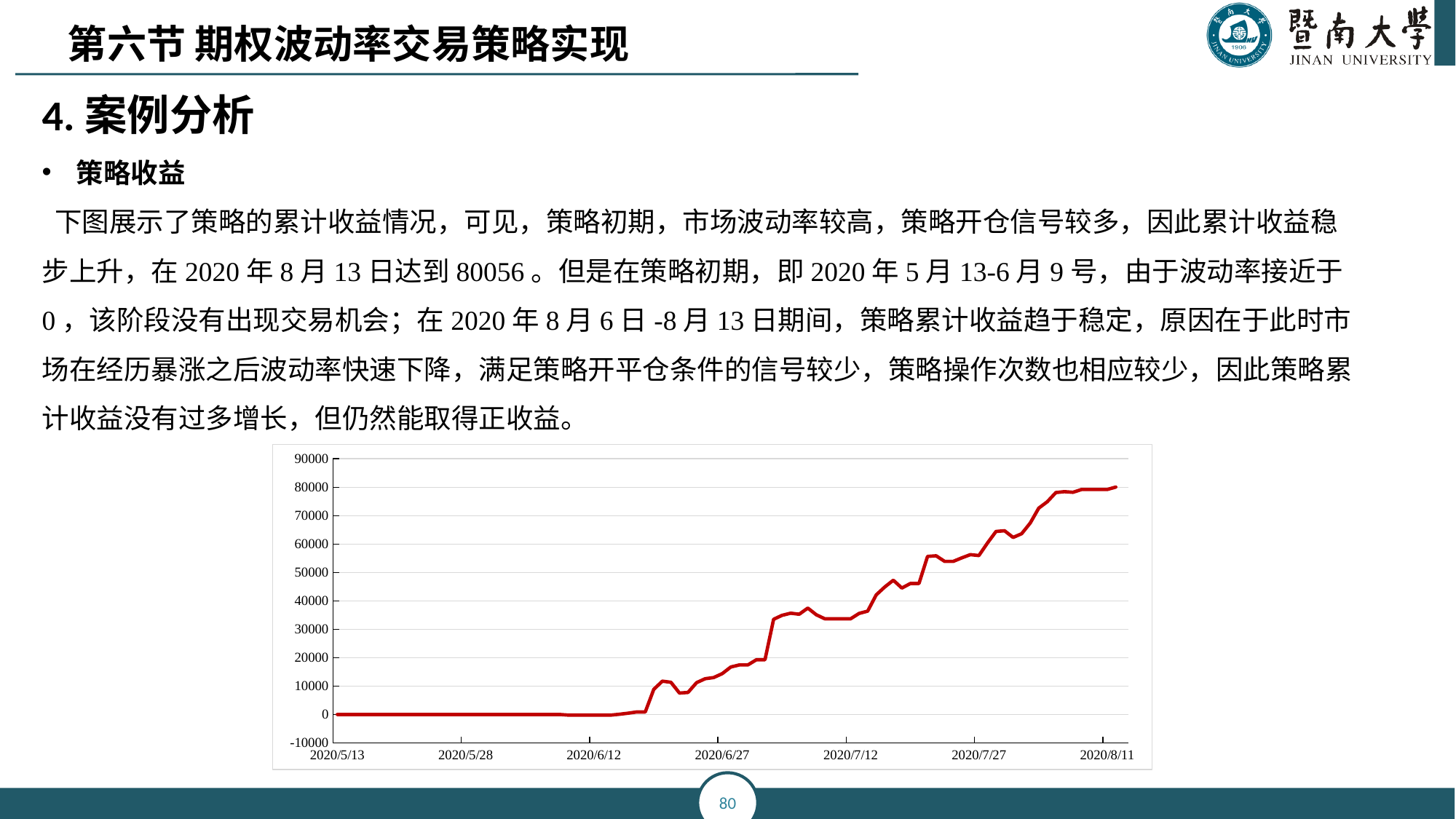
What kind of chart is shown on the slide? line chart What colour is the line in the chart? red Is the value at 2020/8/11 greater or less than 70000? greater Is the value at 2020/6/27 greater or less than 20000? less Is the value at 2020/7/27 greater or less than 50000? greater What is the highest value shown on the y axis? 90000 How many date labels are shown on the x axis? 7 Which is larger, the value at 2020/7/12 or the value at 2020/7/27? 2020/7/27 Do the values in the chart generally rise or fall from 2020/5/13 to 2020/8/11? rise